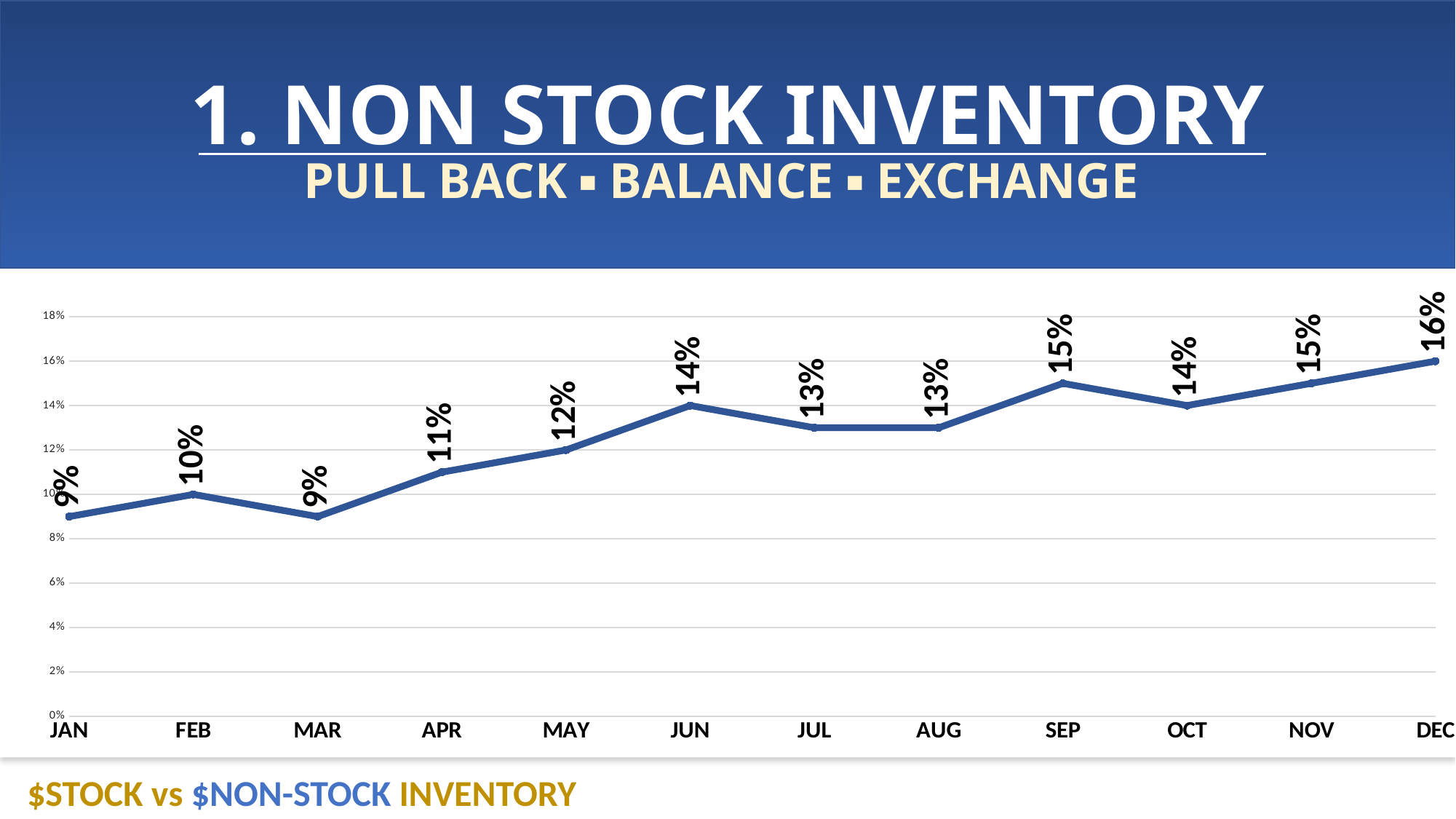
What is the main title of the slide? 1. NON STOCK INVENTORY How many months are plotted on the x axis? 12 Which is larger, the value for APR or the value for OCT? OCT What is the value for SEP? 15% What is the value for FEB? 10% What is the value for JUN? 14% Do the values generally rise or fall from JAN to DEC? rise Is the value for MAY greater or less than 10%? greater What is the difference between the values for DEC and JAN? 7% What is the difference between the values for SEP and OCT? 1% What kind of chart is shown on the slide? line chart Which month has the highest value? DEC